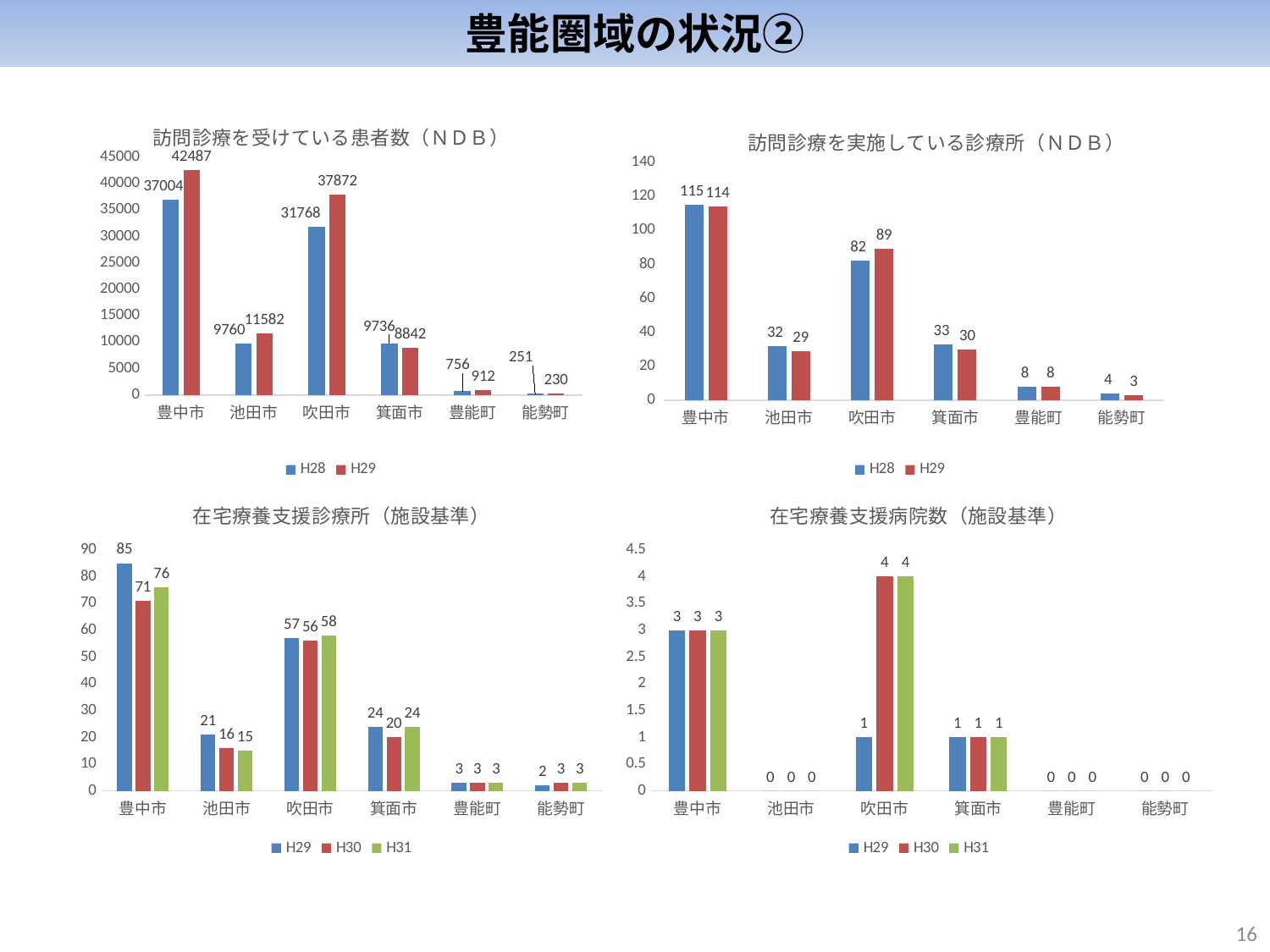
In the top-left chart 訪問診療を受けている患者数（ＮＤＢ）, what is the difference between the H29 and H28 values for 吹田市? 6104 In the top-right chart 訪問診療を実施している診療所（ＮＤＢ）, how many series does the legend list? 2 In the bottom-left chart 在宅療養支援診療所（施設基準）, what is the difference between the H29 and H31 values for 池田市? 6 In the top-right chart 訪問診療を実施している診療所（ＮＤＢ）, which city has the lowest H29 value? 能勢町 In the top-left chart 訪問診療を受けている患者数（ＮＤＢ）, what is the H29 value for 豊中市? 42487 In the bottom-left chart 在宅療養支援診療所（施設基準）, how many categories are shown on the x axis? 6 In the bottom-right chart 在宅療養支援病院数（施設基準）, what is the H31 value for 吹田市? 4 In the top-left chart 訪問診療を受けている患者数（ＮＤＢ）, which city has the highest H28 value? 豊中市 In the top-right chart 訪問診療を実施している診療所（ＮＤＢ）, what is the H29 value for 吹田市? 89 What type of chart is the bottom-right chart 在宅療養支援病院数（施設基準）? bar chart In the top-left chart 訪問診療を受けている患者数（ＮＤＢ）, which is larger for 箕面市, the H28 value or the H29 value? H28 In the bottom-left chart 在宅療養支援診療所（施設基準）, what is the H30 value for 豊中市? 71